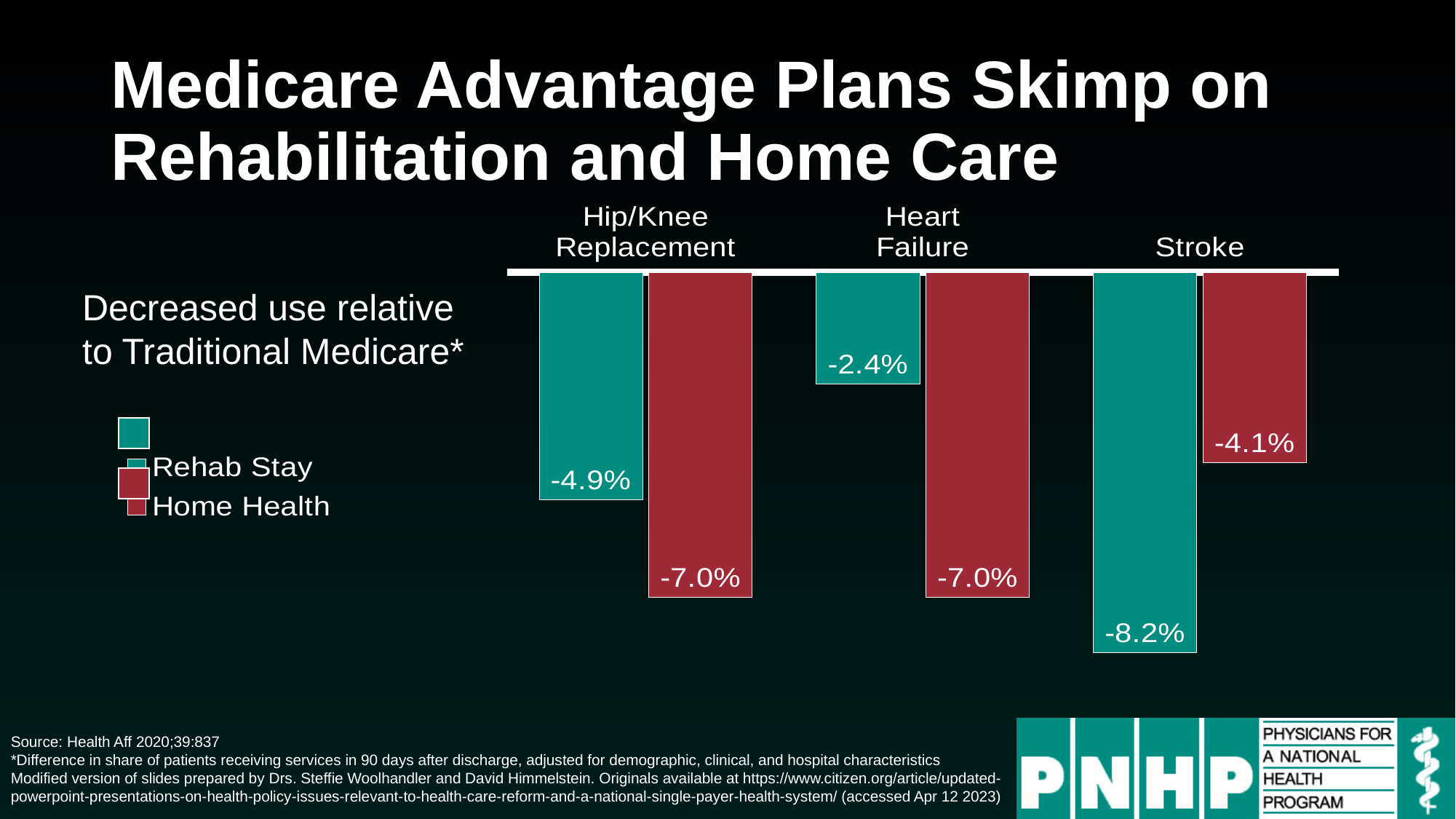
What is the Home Health value for Stroke? -4.1% For Stroke, which series shows the larger decrease, Rehab Stay or Home Health? Rehab Stay Which category has the largest decrease in Rehab Stay use? Stroke How many categories are shown on the x axis? 3 How many series does the legend list? 2 What is the difference between the Home Health and Rehab Stay values for Heart Failure? 4.6 percentage points Which colour represents the Home Health series? Red What is the Home Health value for Heart Failure? -7.0% What kind of chart is shown on the slide? Bar chart Which category has the smallest decrease in Rehab Stay use? Heart Failure What is the Rehab Stay value for Stroke? -8.2% What is the Rehab Stay value for Hip/Knee Replacement? -4.9%